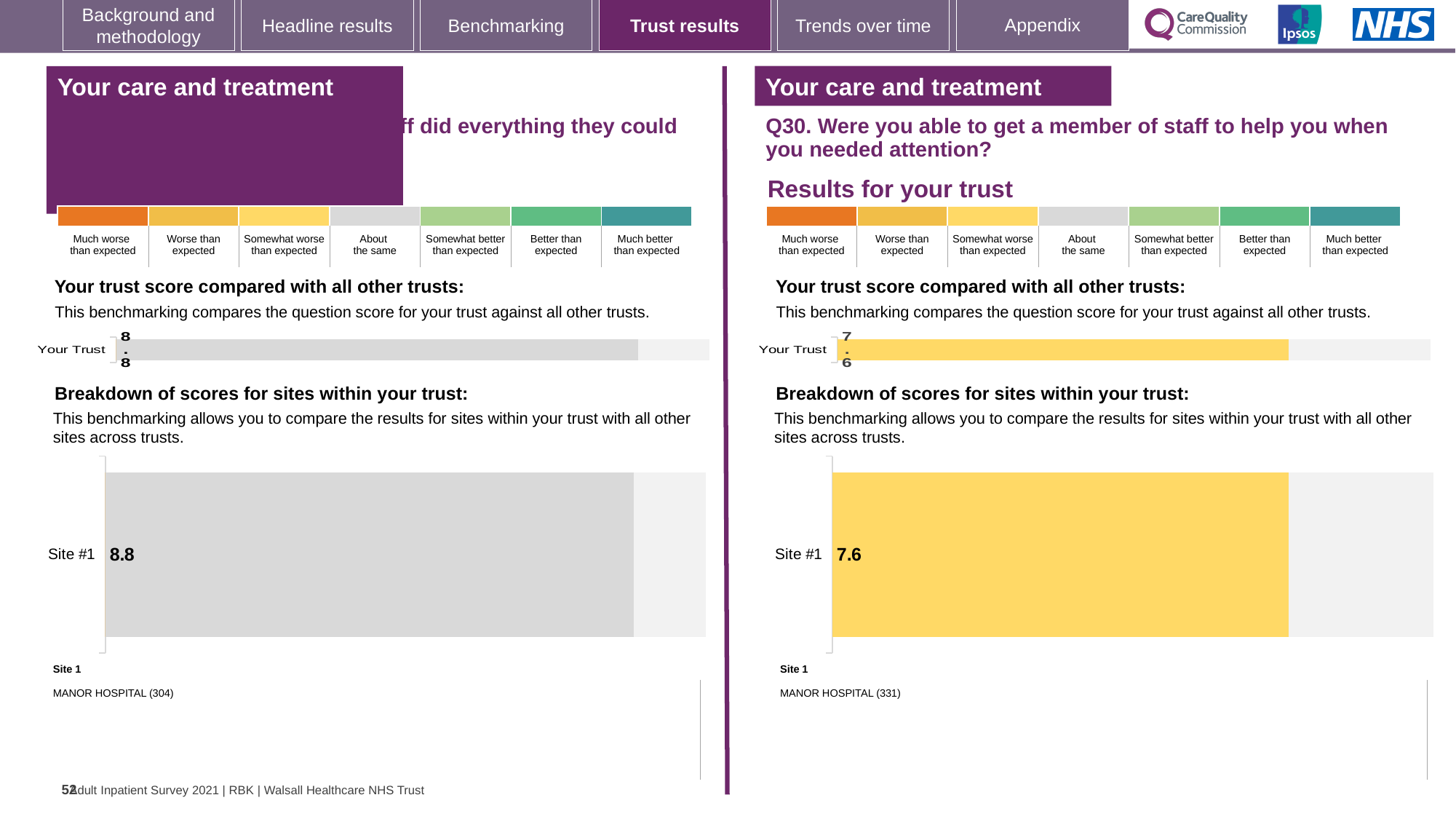
How many sites are shown in the breakdown of scores for sites on the right-hand side of the slide (Q30)? 1 On the right-hand side of the slide (Q30), what is the score shown for Site #1? 7.6 Which is larger: the Site #1 score on the left-hand side of the slide or the Site #1 score on the right-hand side (Q30)? Left-hand side (8.8) Which site is listed as Site 1 on the left-hand side of the slide? MANOR HOSPITAL (304) What kind of chart is used to show the Site #1 score on the right-hand side of the slide (Q30)? Bar chart On the left-hand side of the slide, what is the score shown for Your Trust? 8.8 On the right-hand side of the slide (Q30), is the Your Trust score the same as the Site #1 score? Yes Which site is listed as Site 1 on the right-hand side of the slide (Q30)? MANOR HOSPITAL (331) On the right-hand side of the slide (Q30), what is the score shown for Your Trust? 7.6 On the left-hand side of the slide, what is the score shown for Site #1? 8.8 What is the difference between the Site #1 score on the left-hand side of the slide and the Site #1 score on the right-hand side (Q30)? 1.2